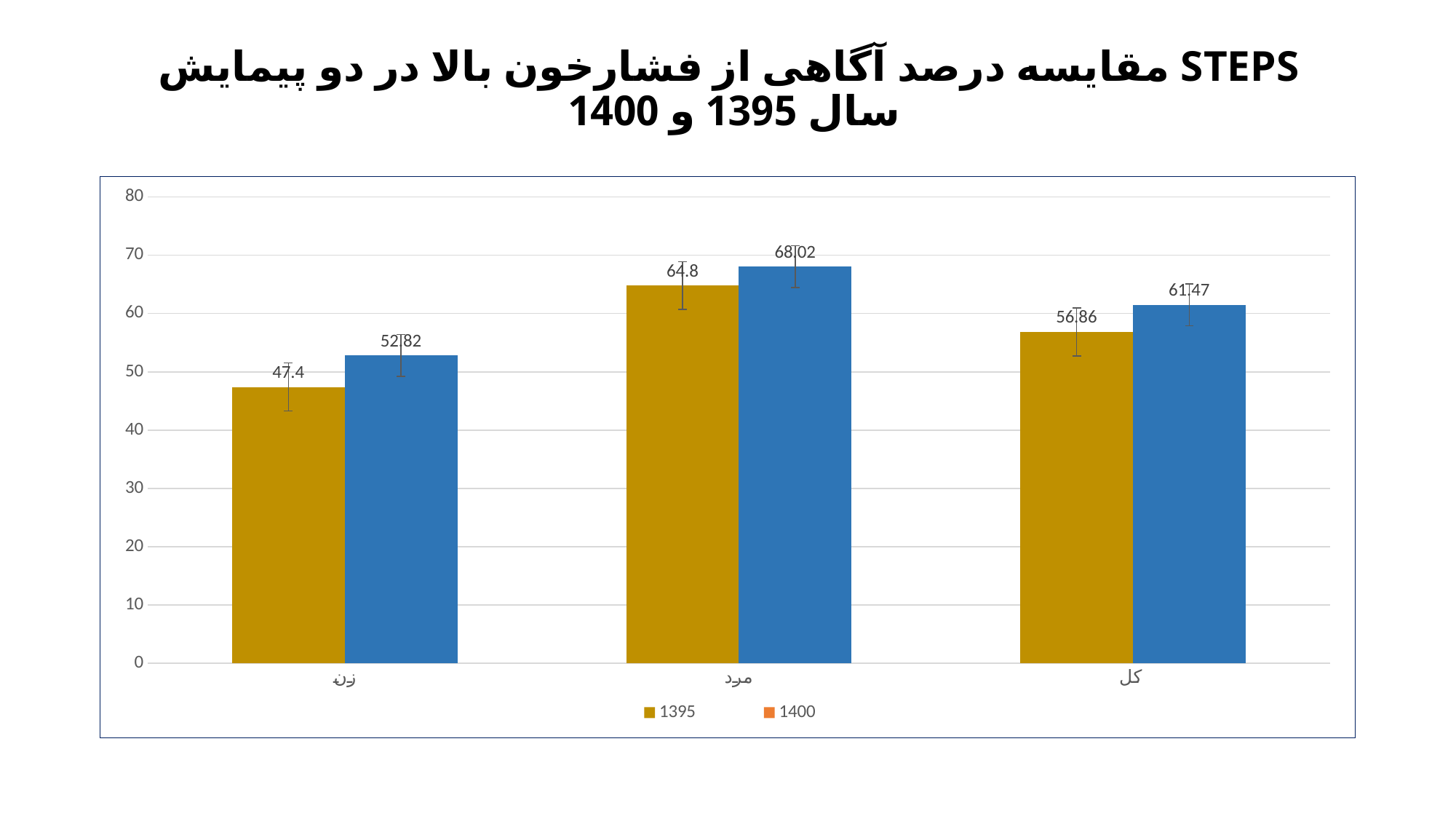
Is the 1395 value for مرد greater or less than 60? greater Which category has the highest value in the 1400 series? مرد What is the value for کل in the 1395 series? 56.86 What is the difference between the 1400 and 1395 values for کل? 4.61 What is the value for مرد in the 1400 series? 68.02 Which category has the lowest value in the 1395 series? زن For مرد, which series has the larger value, 1395 or 1400? 1400 What is the value for زن in the 1395 series? 47.4 What is the difference between the 1400 and 1395 values for زن? 5.42 How many categories are shown on the x axis? 3 What kind of chart is shown on the slide? Bar chart How many series does the legend list? 2